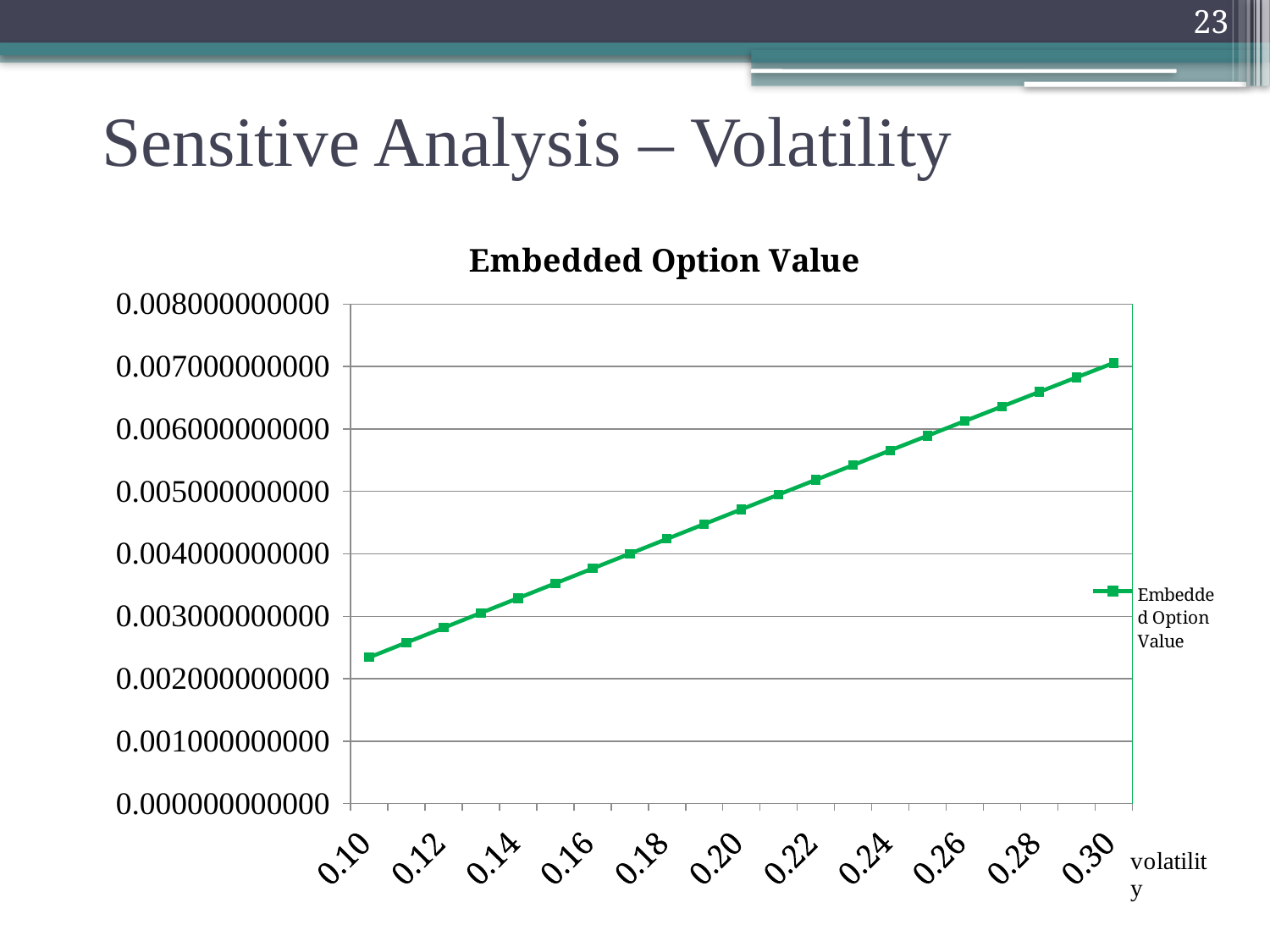
Is the Embedded Option Value at volatility 0.20 greater or less than 0.004000000000? greater What is the title of the chart? Embedded Option Value Is the Embedded Option Value at volatility 0.10 greater or less than 0.002000000000? greater At which volatility is the Embedded Option Value lowest? 0.10 Is the Embedded Option Value at volatility 0.30 greater or less than 0.008000000000? less At which volatility is the Embedded Option Value highest? 0.30 What is the label of the x axis? volatility How many series does the legend list? 1 Which is larger, the Embedded Option Value at volatility 0.12 or at volatility 0.28? 0.28 What kind of chart is shown on the slide? line chart Do the values rise or fall as volatility increases along the x axis? rise